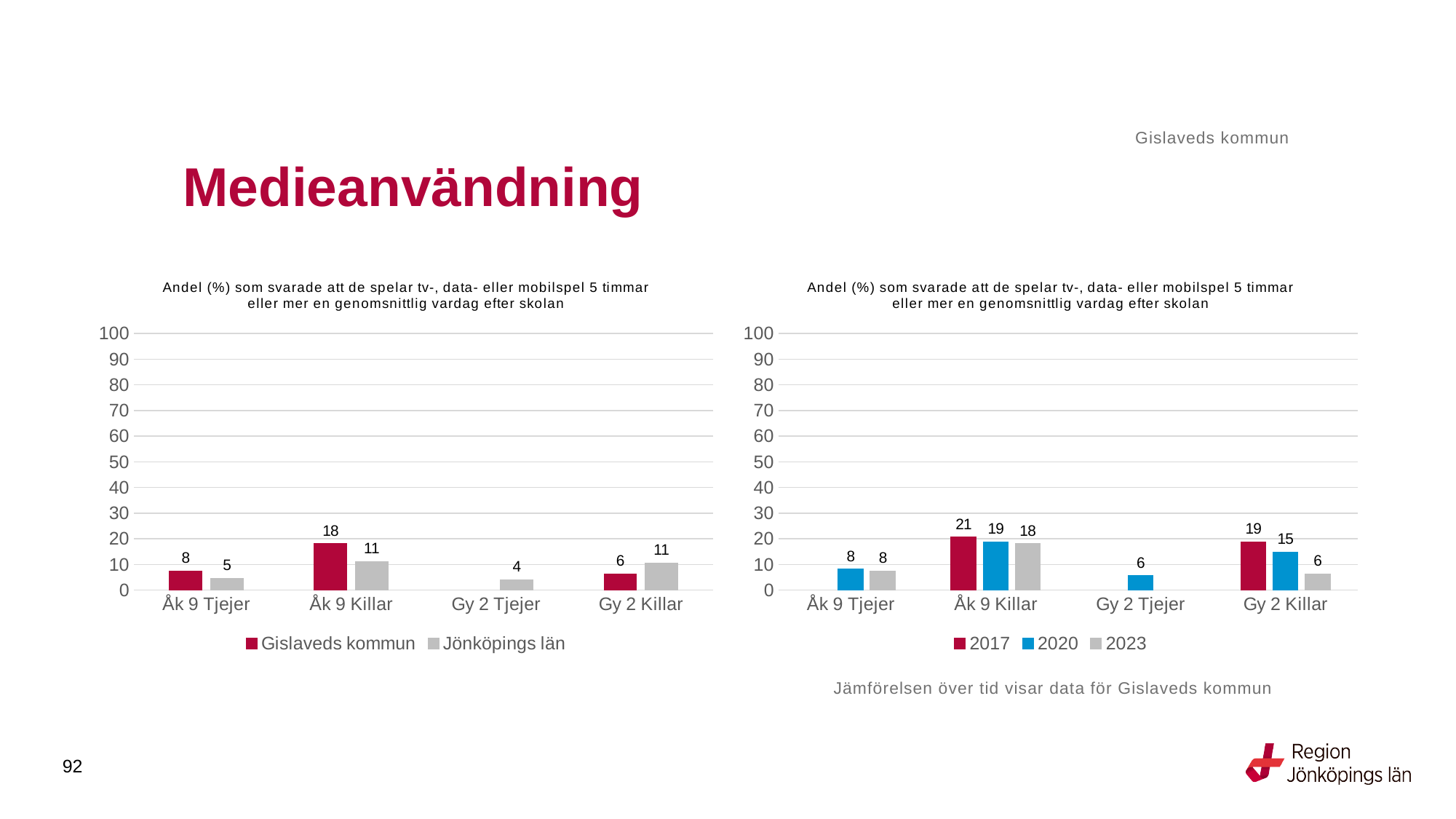
In the right chart, what is the value for 2023 for Gy 2 Killar? 6 How many series does the legend of the left chart list? 2 In the left chart, what is the value for Gislaveds kommun for Åk 9 Killar? 18 In the left chart, what is the value for Jönköpings län for Gy 2 Tjejer? 4 In the left chart, which category has the highest value for Jönköpings län? Åk 9 Killar and Gy 2 Killar (both 11) What type of chart is the right chart? Bar chart In the right chart, what is the value for 2017 for Åk 9 Killar? 21 How many series does the legend of the right chart list? 3 In the right chart, which category has the lowest value for 2020? Gy 2 Tjejer In the left chart, what is the difference between Gislaveds kommun and Jönköpings län for Åk 9 Killar? 7 In the left chart, for Gy 2 Killar, which is larger: Gislaveds kommun or Jönköpings län? Jönköpings län In the right chart, what is the difference between 2017 and 2023 for Gy 2 Killar? 13